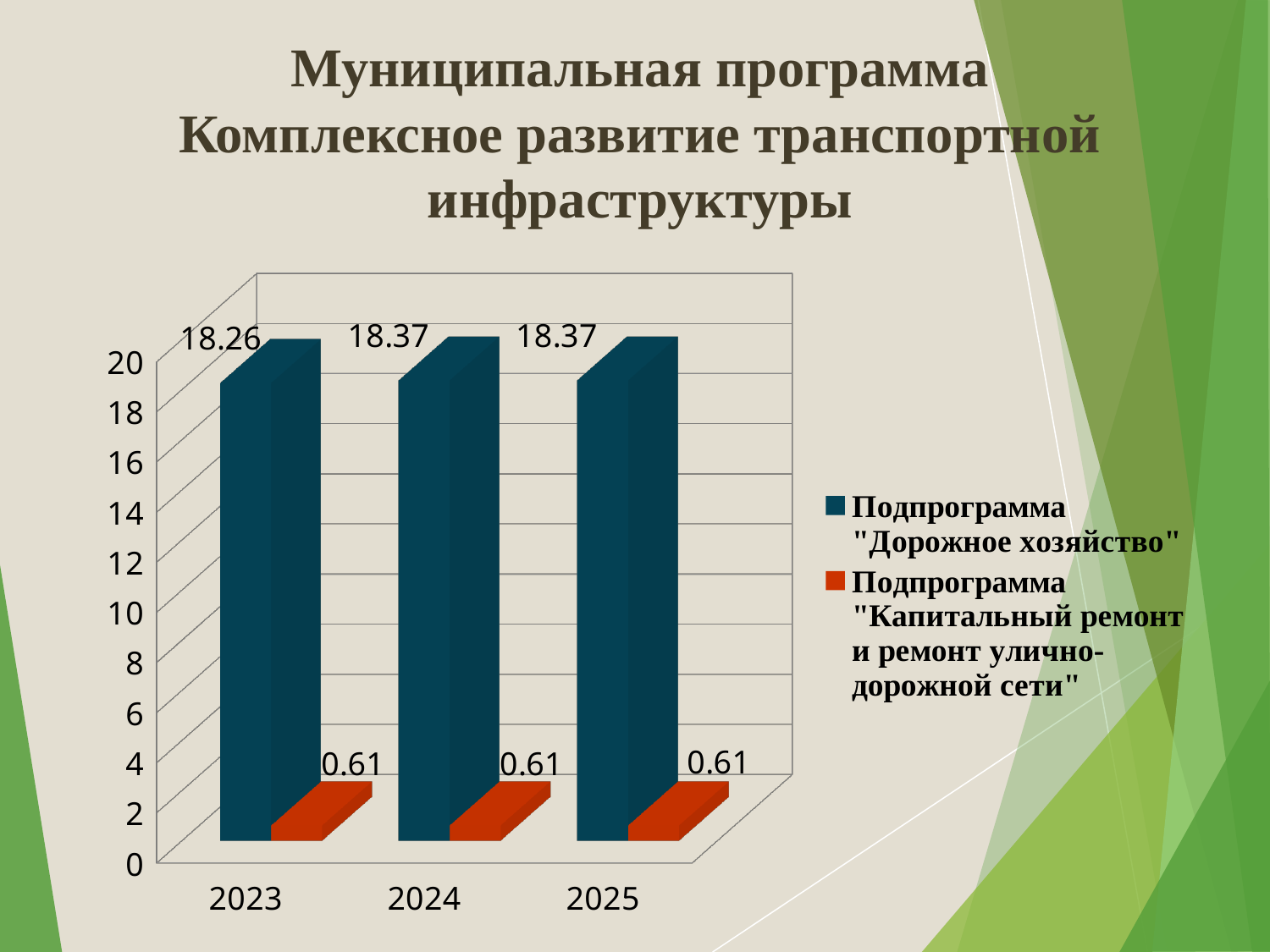
Which subprogramme has the larger value in 2025? Подпрограмма "Дорожное хозяйство" What is the value for Подпрограмма "Дорожное хозяйство" in 2023? 18.26 Is the value for Подпрограмма "Дорожное хозяйство" in 2025 greater or less than 16? greater What is the difference between the Подпрограмма "Дорожное хозяйство" values for 2024 and 2023? 0.11 What kind of chart is shown on the slide? bar chart What is the difference between the two subprogrammes' values in 2024? 17.76 What is the value for Подпрограмма "Капитальный ремонт и ремонт улично-дорожной сети" in 2025? 0.61 How many years are shown on the x axis? 3 Which year has the lowest value for Подпрограмма "Дорожное хозяйство"? 2023 What colour are the bars for Подпрограмма "Капитальный ремонт и ремонт улично-дорожной сети"? red How many series does the legend list? 2 What is the value for Подпрограмма "Дорожное хозяйство" in 2024? 18.37